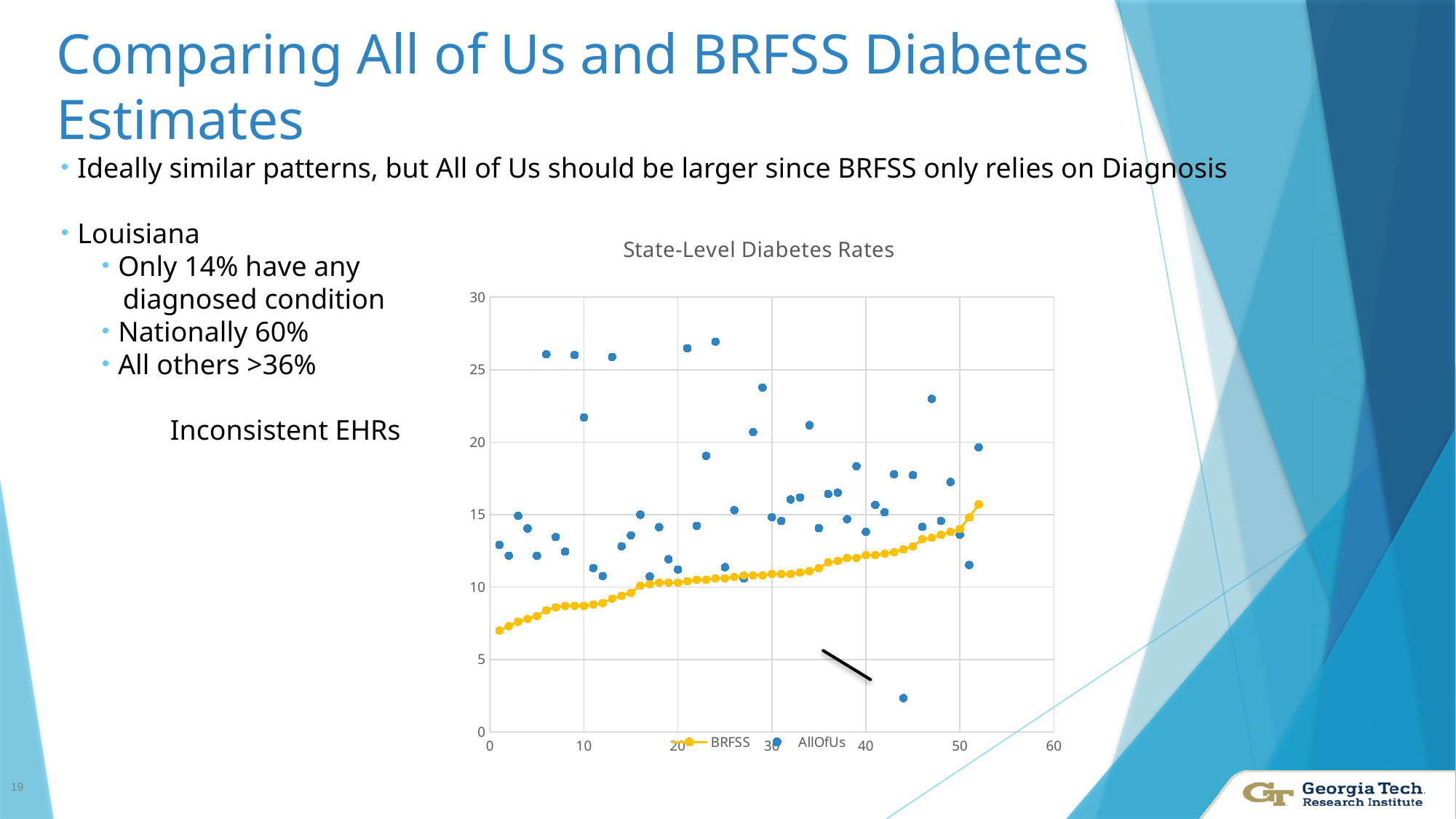
In the 'State-Level Diabetes Rates' chart, is the highest BRFSS value greater or less than 20? less Which two series are listed in the legend of the 'State-Level Diabetes Rates' chart? BRFSS and AllOfUs In the 'State-Level Diabetes Rates' chart, which series has the single highest plotted value, BRFSS or AllOfUs? AllOfUs In the 'State-Level Diabetes Rates' chart, is the highest AllOfUs value greater or less than 25? greater What kind of chart is the 'State-Level Diabetes Rates' chart? Scatter chart In the 'State-Level Diabetes Rates' chart, is the lowest BRFSS value greater or less than 10? less What is the maximum value shown on the y axis of the 'State-Level Diabetes Rates' chart? 30 How many series does the legend of the 'State-Level Diabetes Rates' chart list? 2 In the 'State-Level Diabetes Rates' chart, do the BRFSS values rise or fall as the x axis increases? Rise What is the title of the chart on the slide? State-Level Diabetes Rates In the 'State-Level Diabetes Rates' chart, which series has the single lowest plotted value, BRFSS or AllOfUs? AllOfUs